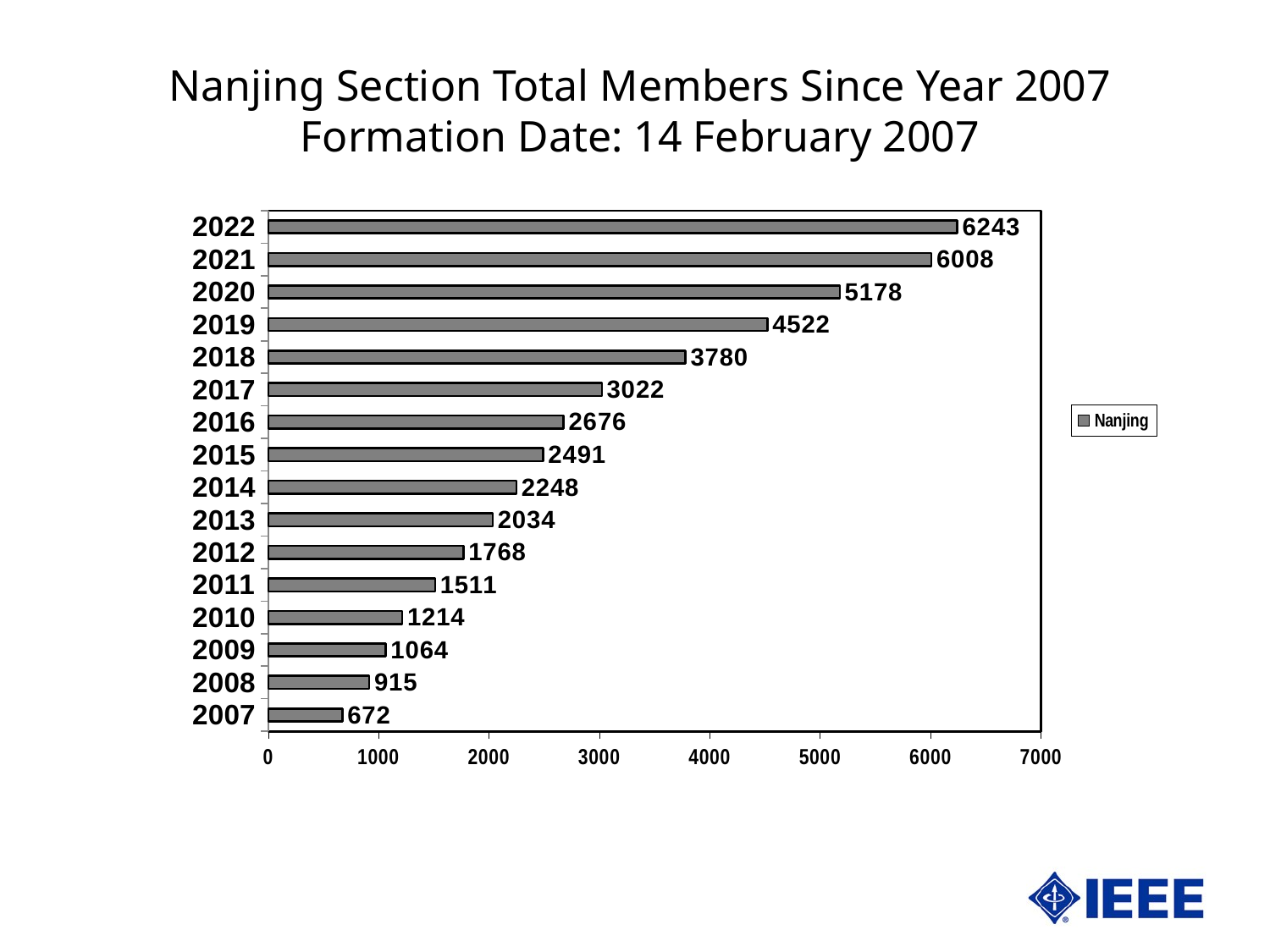
What is the difference between the values for 2022 and 2021? 235 What is the value shown for 2007? 672 How many years are shown in the chart? 16 Is the value for 2016 greater or less than 3000? less What series name does the legend show? Nanjing What is the total number of Nanjing Section members in 2022? 6243 Which is larger, the value for 2019 or the value for 2020? 2020 What kind of chart is shown on the slide? bar chart Which year has the highest number of members? 2022 What is the value shown for 2015? 2491 What is the difference between the values for 2018 and 2017? 758 Which year has the lowest number of members? 2007